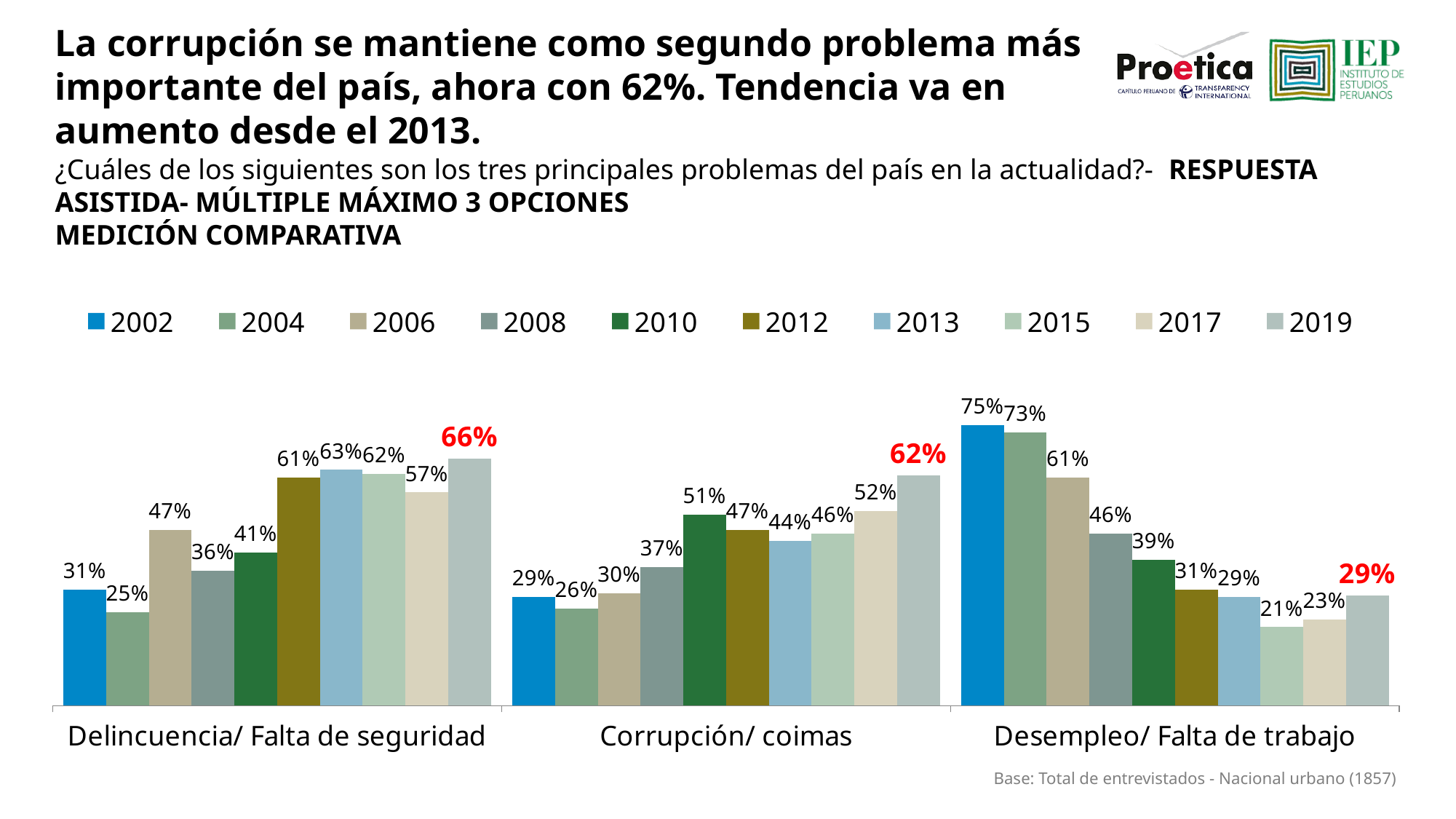
How many categories are shown on the x axis? 3 Which category has the highest value in 2019? Delincuencia/ Falta de seguridad How many series does the legend list? 10 What is the value for Delincuencia/ Falta de seguridad in 2006? 47% What kind of chart is this? Bar chart Do the values for Desempleo/ Falta de trabajo rise or fall from 2002 to 2015? Fall Which category has the lowest value in 2015? Desempleo/ Falta de trabajo What is the difference between the 2019 and 2002 values for Corrupción/ coimas? 33 percentage points Which year's series is shown in the darkest green colour? 2010 What is the value for Desempleo/ Falta de trabajo in 2002? 75% What is the value for Corrupción/ coimas in 2019? 62% Which is larger: the 2010 value for Corrupción/ coimas or the 2010 value for Delincuencia/ Falta de seguridad? Corrupción/ coimas